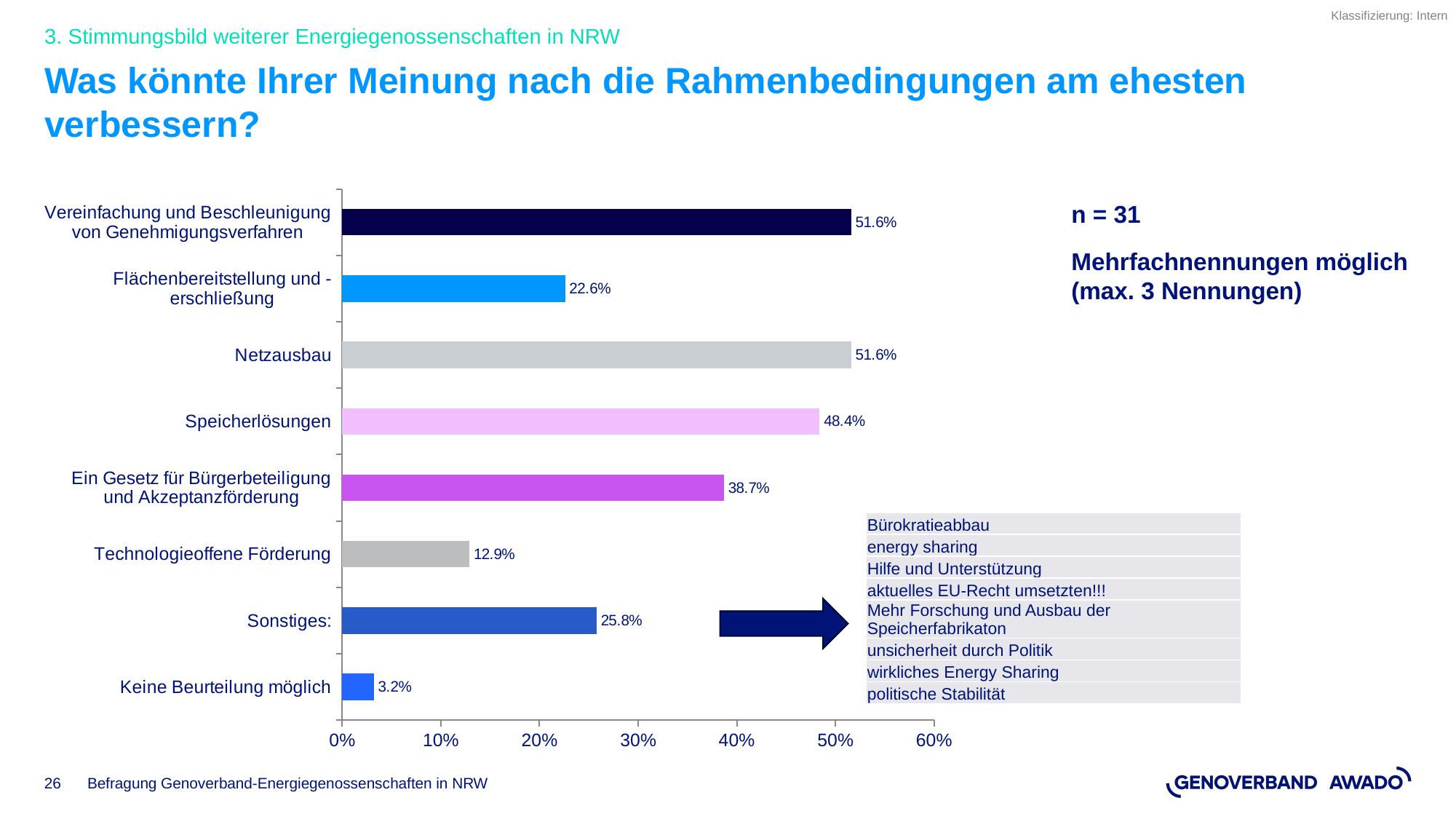
Which is larger, the value for Sonstiges or the value for Flächenbereitstellung und -erschließung? Sonstiges What is the value for Flächenbereitstellung und -erschließung? 22.6% How many categories does the bar chart show? 8 Is the value for Ein Gesetz für Bürgerbeteiligung und Akzeptanzförderung greater or less than 40%? less What sample size (n) is stated next to the chart? n = 31 What is the value for Speicherlösungen? 48.4% What is the difference between the values for Ein Gesetz für Bürgerbeteiligung und Akzeptanzförderung and Technologieoffene Förderung? 25.8% Which category has the lowest value? Keine Beurteilung möglich What is the difference between the values for Netzausbau and Speicherlösungen? 3.2% What is the value for Technologieoffene Förderung? 12.9% What kind of chart is shown on the slide? bar chart What is the value for Sonstiges? 25.8%